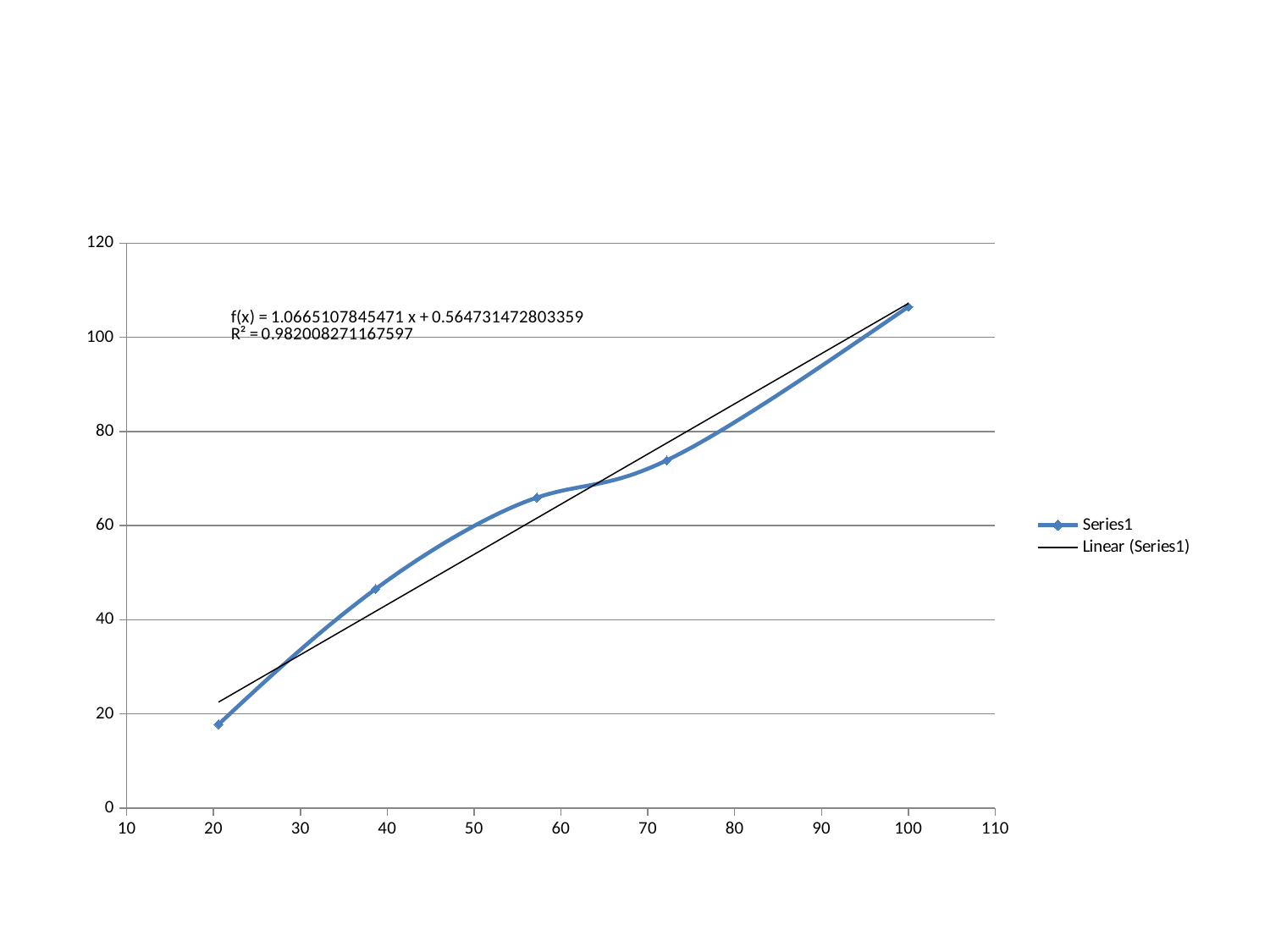
What kind of chart is shown on the slide? Scatter chart with a smoothed line and a linear trendline Is the Series1 value at x = 100 greater or less than 100? greater What are the two entries listed in the legend? Series1 and Linear (Series1) Do the Series1 values rise or fall as x increases from 20 to 100? rise Is the Series1 value at the data point near x = 72 greater or less than 80? less Is the Series1 value at the data point near x = 39 greater or less than 40? greater What R² value is printed on the chart for the linear trendline? 0.982008271167597 How many data points are plotted for Series1? 5 Which data point has the highest Series1 value, the one at x = 100 or the one near x = 72? the one at x = 100 How many entries does the legend list? 2